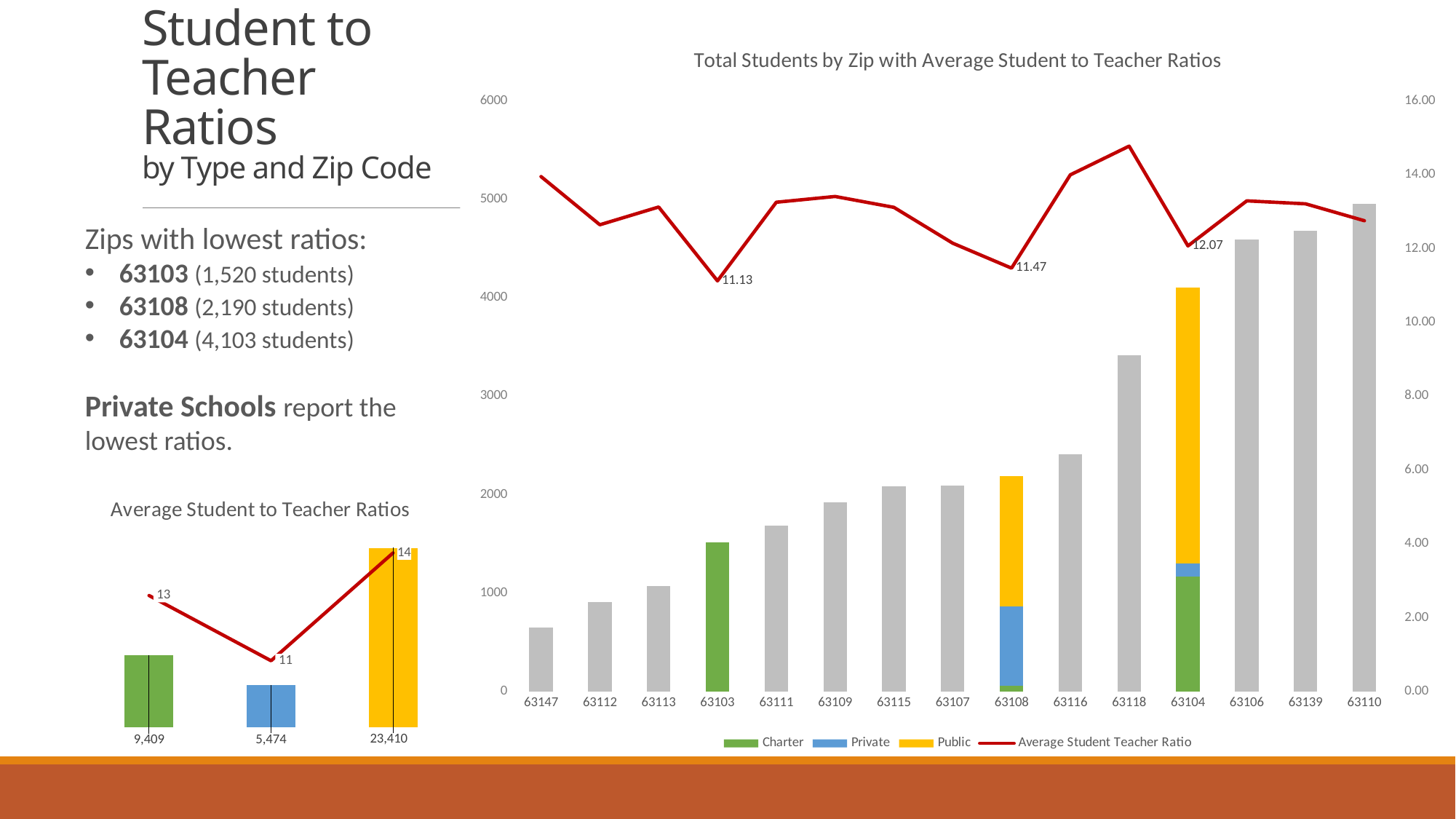
In the chart titled 'Total Students by Zip with Average Student to Teacher Ratios', is the total students bar for 63118 greater or less than 3000? greater In the chart titled 'Total Students by Zip with Average Student to Teacher Ratios', what is the average student teacher ratio labelled for zip 63108? 11.47 In the chart titled 'Total Students by Zip with Average Student to Teacher Ratios', what is the difference between the labelled ratios for 63108 and 63103? 0.34 In the chart titled 'Total Students by Zip with Average Student to Teacher Ratios', how many entries does the legend list? 4 In the chart titled 'Total Students by Zip with Average Student to Teacher Ratios', what is the average student teacher ratio labelled for zip 63103? 11.13 In the chart titled 'Total Students by Zip with Average Student to Teacher Ratios', what is the average student teacher ratio labelled for zip 63104? 12.07 In the chart titled 'Average Student to Teacher Ratios' on the left, what is the highest ratio value labelled on the line? 14 In the chart titled 'Average Student to Teacher Ratios' on the left, how many bars are shown? 3 In the chart titled 'Total Students by Zip with Average Student to Teacher Ratios', how many zip codes are shown on the x axis? 15 In the chart titled 'Total Students by Zip with Average Student to Teacher Ratios', which zip code has the highest total students bar? 63110 In the chart titled 'Total Students by Zip with Average Student to Teacher Ratios', which zip code has the lowest average student teacher ratio? 63103 In the chart titled 'Total Students by Zip with Average Student to Teacher Ratios', do the total students bars rise or fall from left to right along the x axis? rise